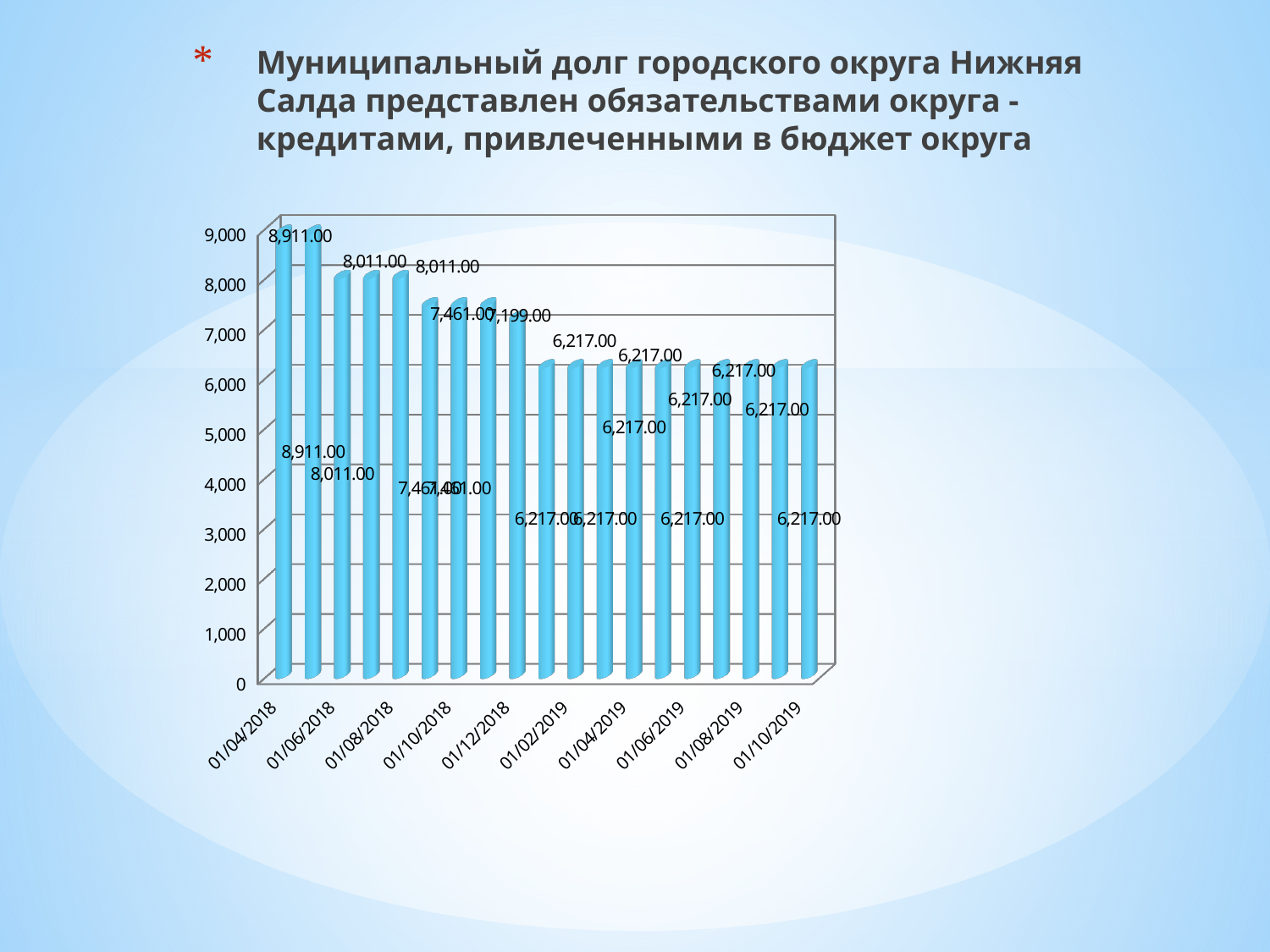
Do the values generally rise or fall from 01/04/2018 to 01/10/2019? fall What is the value for 01/12/2018? 7,199.00 What is the value for 01/10/2018? 7,461.00 What is the highest value shown on the chart? 8,911.00 What is the lowest value shown on the chart? 6,217.00 How many bars are plotted on the chart? 19 What is the difference between the values for 01/04/2018 and 01/10/2019? 2,694.00 What is the value for 01/08/2018? 8,011.00 Which is larger, the value for 01/06/2018 or the value for 01/02/2019? 01/06/2018 Is the value for 01/04/2019 greater or less than 7,000? less What is the value for 01/04/2018? 8,911.00 What is the value for 01/10/2019? 6,217.00